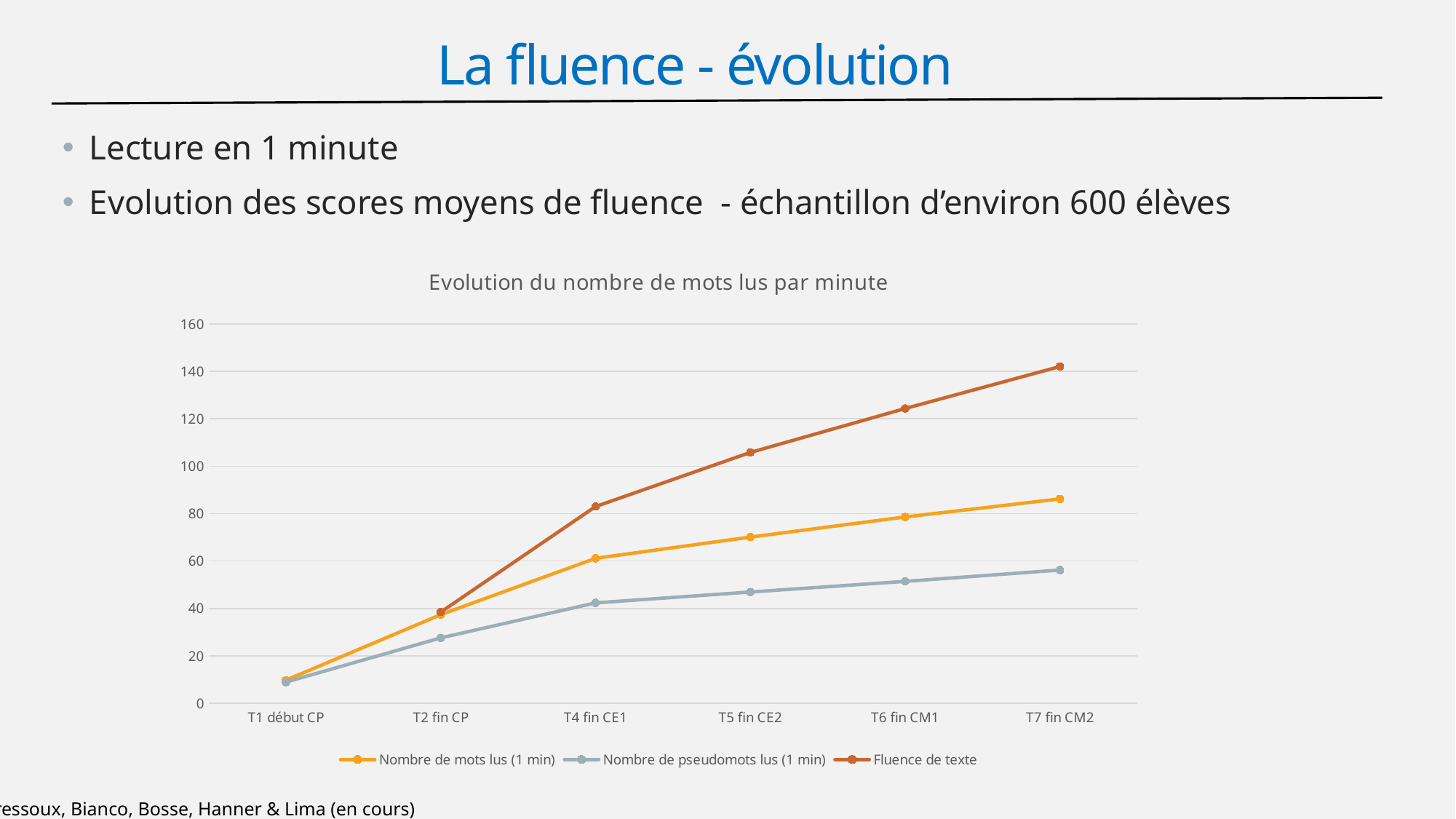
At T4 fin CE1, which is larger: Nombre de mots lus (1 min) or Nombre de pseudomots lus (1 min)? Nombre de mots lus (1 min) How many time points are shown on the x axis? 6 Is the value for Fluence de texte at T4 fin CE1 greater or less than 100? less What kind of chart is shown on the slide? line chart Is the value for Nombre de mots lus (1 min) at T7 fin CM2 greater or less than 80? greater Which series has the highest value at T7 fin CM2? Fluence de texte How many series does the legend list? 3 Is the value for Fluence de texte at T7 fin CM2 greater or less than 120? greater Do the values of the Fluence de texte series rise or fall from T1 début CP to T7 fin CM2? rise Which series has the lowest value at T7 fin CM2? Nombre de pseudomots lus (1 min) What is the title of the chart? Evolution du nombre de mots lus par minute